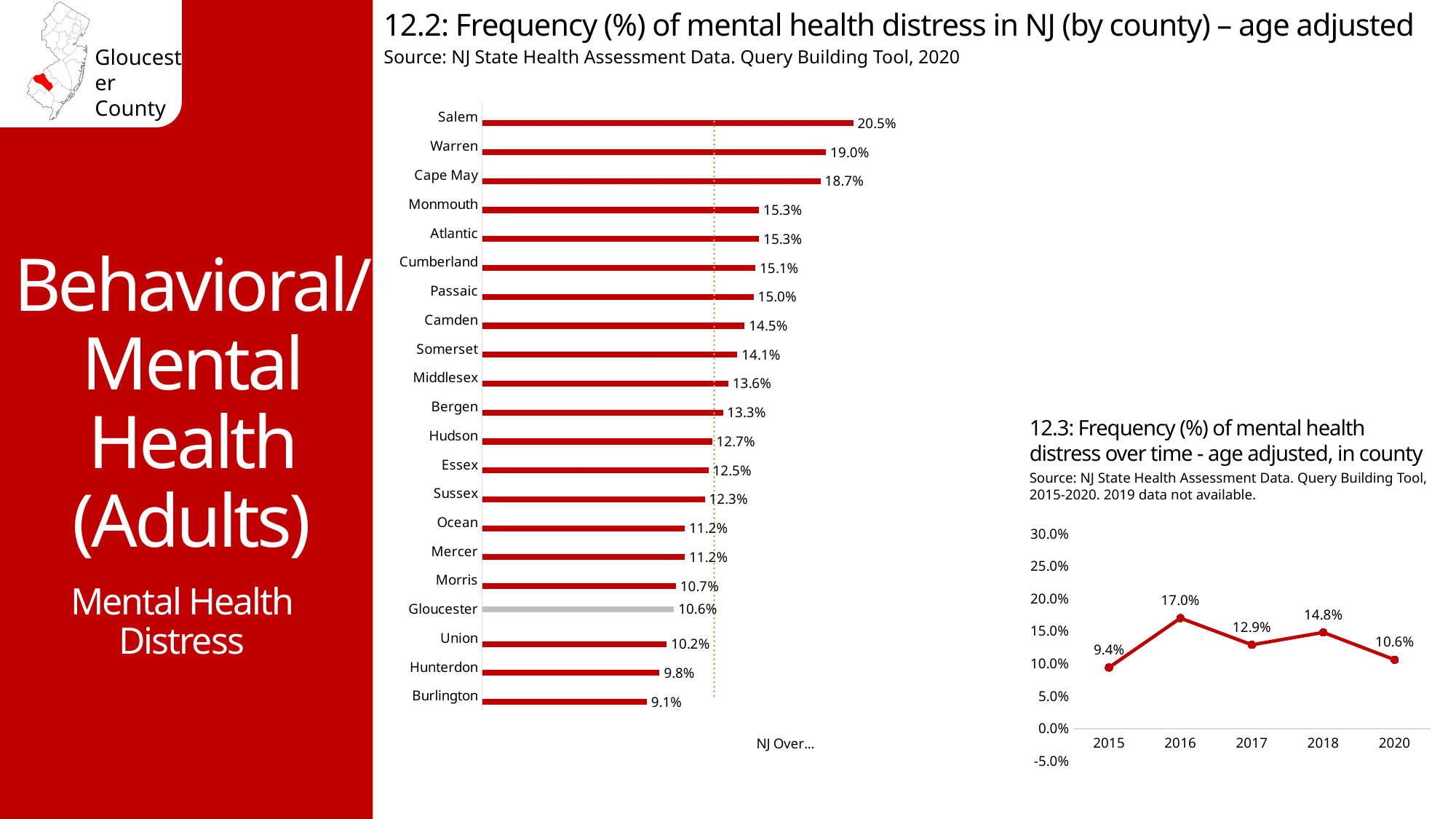
In the chart '12.2: Frequency (%) of mental health distress in NJ (by county) – age adjusted', which county has the lowest value? Burlington In the chart '12.2: Frequency (%) of mental health distress in NJ (by county) – age adjusted', which is larger, the value for Warren or the value for Camden? Warren What kind of chart is '12.3: Frequency (%) of mental health distress over time - age adjusted, in county'? Line chart What kind of chart is '12.2: Frequency (%) of mental health distress in NJ (by county) – age adjusted'? Bar chart In the chart '12.2: Frequency (%) of mental health distress in NJ (by county) – age adjusted', how many counties are shown? 21 In the chart '12.2: Frequency (%) of mental health distress in NJ (by county) – age adjusted', what is the difference between the values for Salem and Burlington? 11.4% In the chart '12.2: Frequency (%) of mental health distress in NJ (by county) – age adjusted', which county has the highest value? Salem In the chart '12.3: Frequency (%) of mental health distress over time - age adjusted, in county', what is the value for 2016? 17.0% In the chart '12.2: Frequency (%) of mental health distress in NJ (by county) – age adjusted', what is the value for Gloucester? 10.6% In the chart '12.3: Frequency (%) of mental health distress over time - age adjusted, in county', what is the difference between the values for 2018 and 2020? 4.2% In the chart '12.2: Frequency (%) of mental health distress in NJ (by county) – age adjusted', what is the value for Cape May? 18.7% In the chart '12.3: Frequency (%) of mental health distress over time - age adjusted, in county', which year has the lowest value? 2015